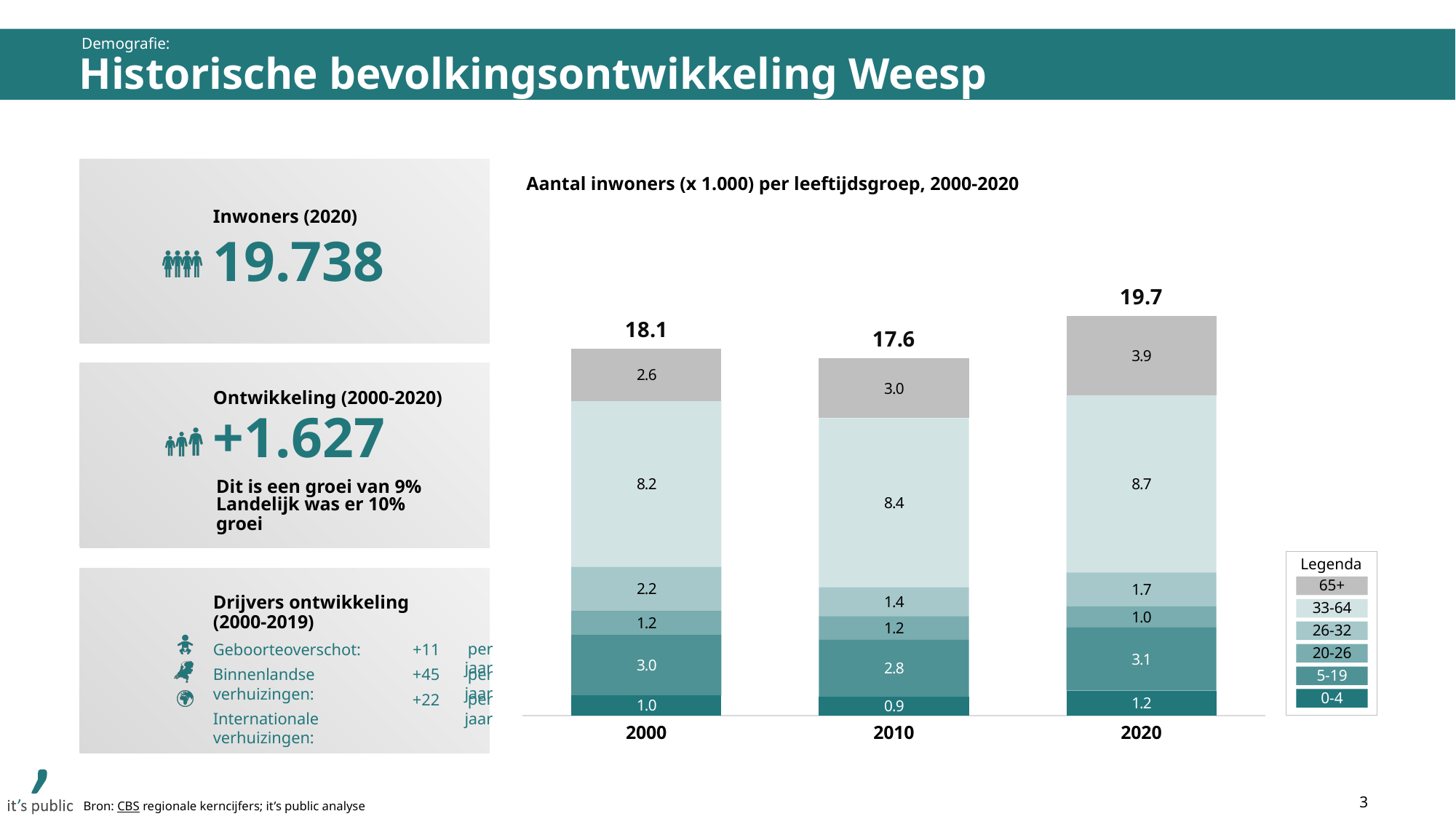
Which year has the highest total number of inhabitants? 2020 What type of chart is shown on the slide? Stacked bar chart What is the title of the chart? Aantal inwoners (x 1.000) per leeftijdsgroep, 2000-2020 How many age groups does the legend list? 6 What is the total of the stacked bar for 2020? 19.7 What is the value for the 65+ age group in 2020? 3.9 How many years (bars) are shown on the x axis of the chart? 3 What is the difference between the 65+ values for 2020 and 2000? 1.3 What is the value for the 0-4 age group in 2000? 1.0 Which year has the lowest total number of inhabitants? 2010 What is the value for the 33-64 age group in 2010? 8.4 Is the 5-19 value larger in 2000 or in 2010? 2000